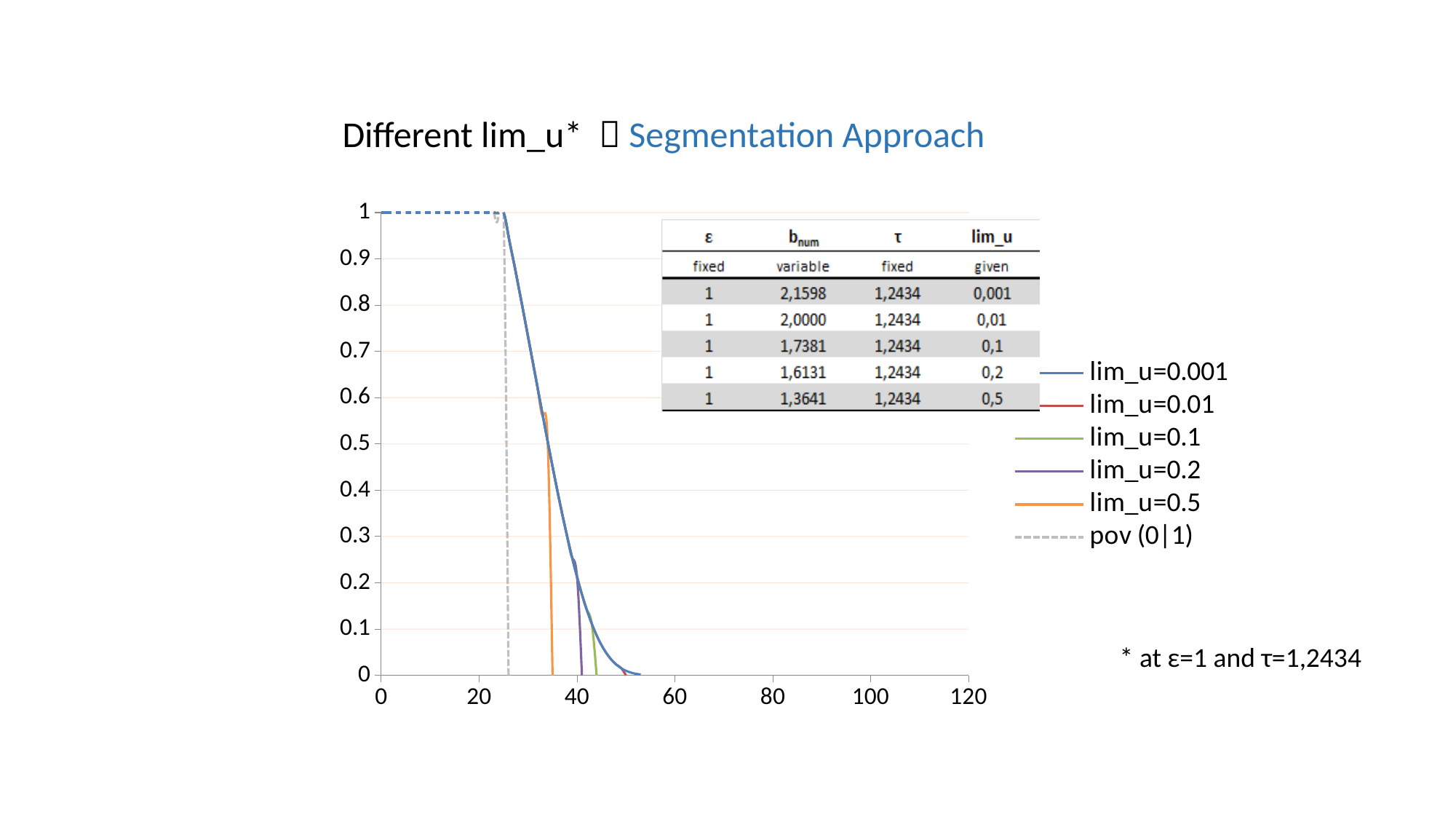
Is the value of the lim_u=0.001 series at x=40 greater or less than 0.5? less Which legend series reaches zero at the smallest x value? pov (0|1) Is the value of the lim_u=0.001 series at x=30 greater or less than 0.5? greater What is the value of the lim_u=0.001 series at x=0? 1 Which legend entry is drawn as a grey dashed line? pov (0|1) What is the maximum value shown on the x axis? 120 Which lim_u series extends furthest along the x axis before reaching zero? lim_u=0.001 How many series does the chart legend list? 6 What kind of chart is shown on the slide? line chart Among the lim_u series, which one drops to zero at the smallest x value? lim_u=0.5 Do the lim_u curves rise or fall as x increases beyond about 25? fall